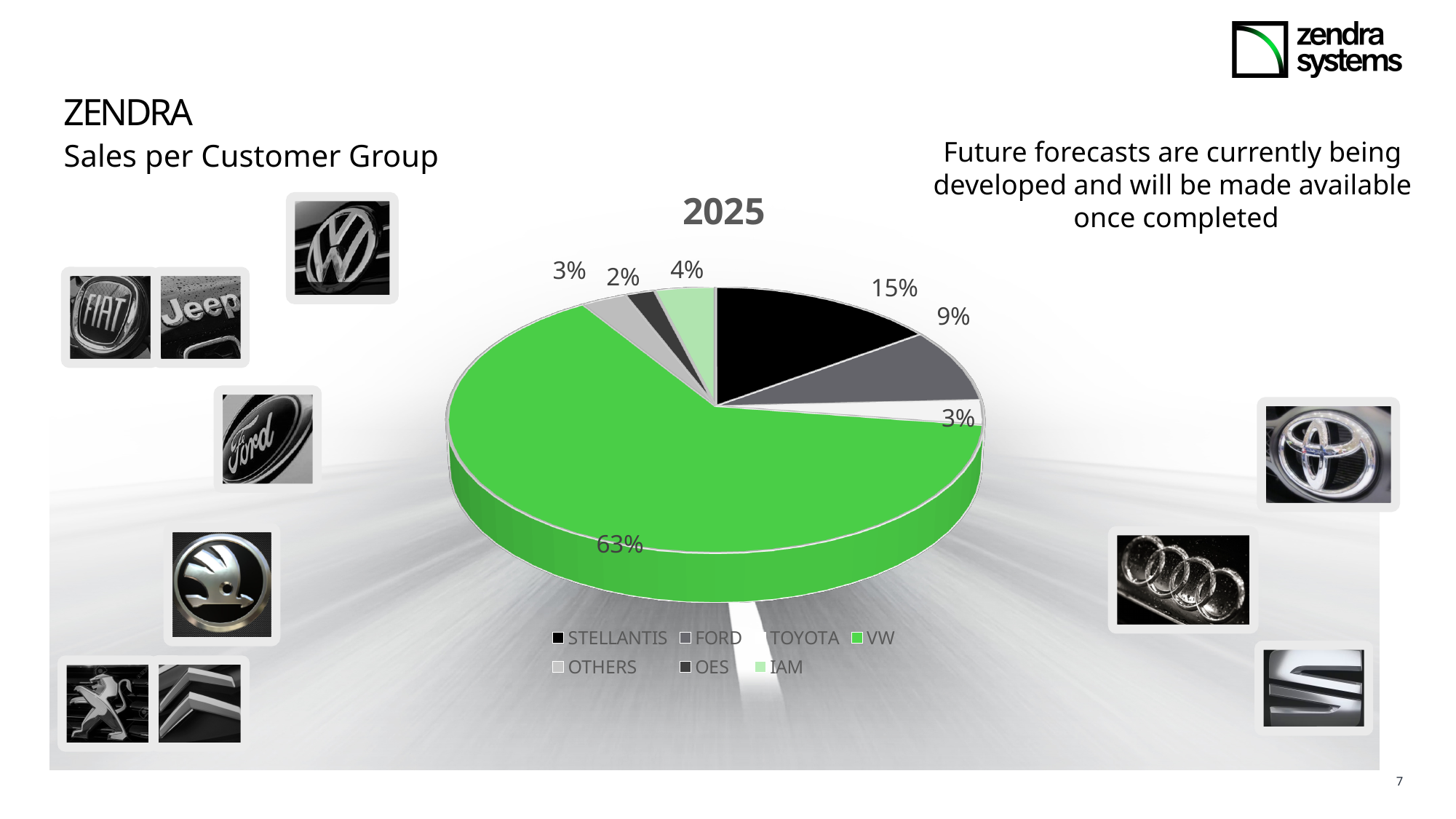
What share of sales does IAM account for in the pie chart? 4% What is the title of the pie chart? 2025 Which slice is larger, FORD or IAM? FORD Which customer group has the largest slice of the pie chart? VW What kind of chart is shown on the slide? pie chart What share of sales does FORD account for in the pie chart? 9% Which customer group has the smallest slice of the pie chart? OES What is the difference in percentage points between the STELLANTIS and FORD slices? 6 What share of sales does OES account for in the pie chart? 2% How many customer groups are listed in the legend of the pie chart? 7 What share of sales does VW account for in the pie chart? 63% What share of sales does STELLANTIS account for in the pie chart? 15%